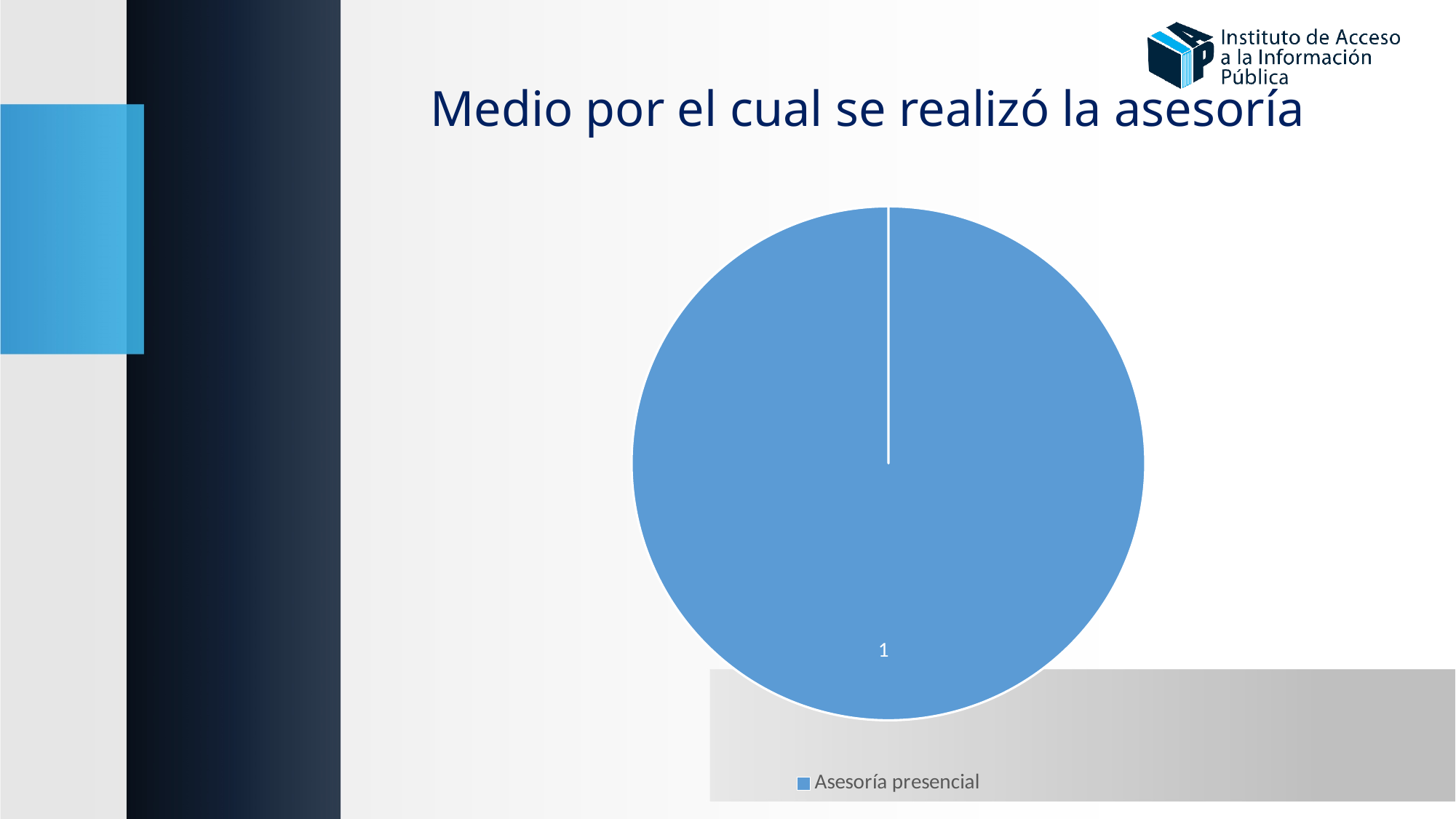
What share of the pie does Asesoría presencial represent? 100% What kind of chart is shown on the slide? pie chart What is the value shown for Asesoría presencial? 1 What is the title of the chart? Medio por el cual se realizó la asesoría How many slices does the pie chart have? 1 What category does the legend list? Asesoría presencial How many entries does the legend list? 1